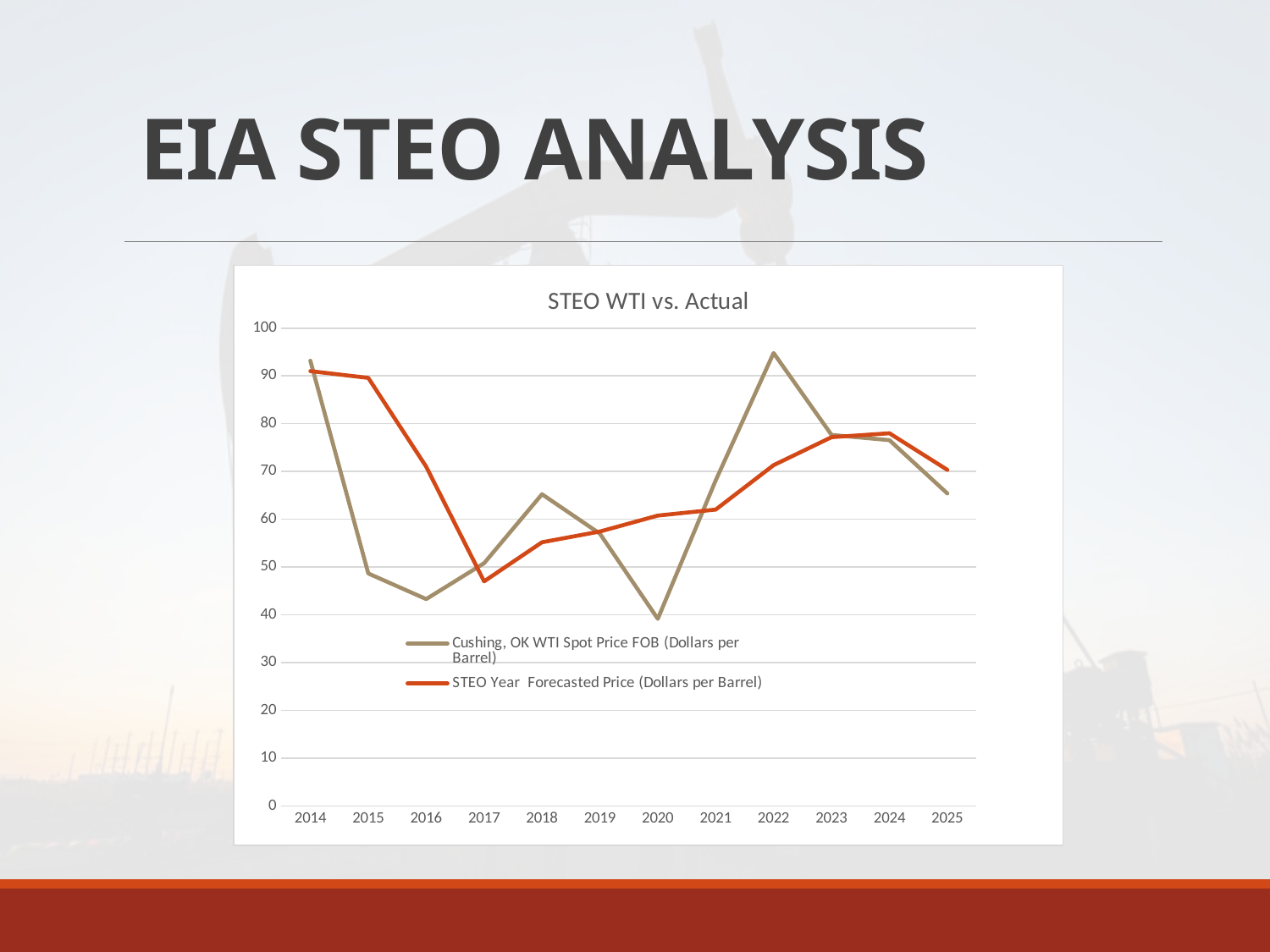
In which year is the STEO Year Forecasted Price highest? 2014 What kind of chart is shown on the slide? Line chart What is the title of the chart? STEO WTI vs. Actual In which year is the Cushing, OK WTI Spot Price FOB lowest? 2020 In which year is the STEO Year Forecasted Price lowest? 2017 In 2022, which is larger: the Cushing, OK WTI Spot Price FOB or the STEO Year Forecasted Price? Cushing, OK WTI Spot Price FOB In 2015, which is larger: the STEO Year Forecasted Price or the Cushing, OK WTI Spot Price FOB? STEO Year Forecasted Price Is the Cushing, OK WTI Spot Price FOB for 2020 greater or less than 50? less How many years are shown on the x axis? 12 Is the STEO Year Forecasted Price for 2016 greater or less than 60? greater In which year is the Cushing, OK WTI Spot Price FOB highest? 2022 How many series does the legend list? 2